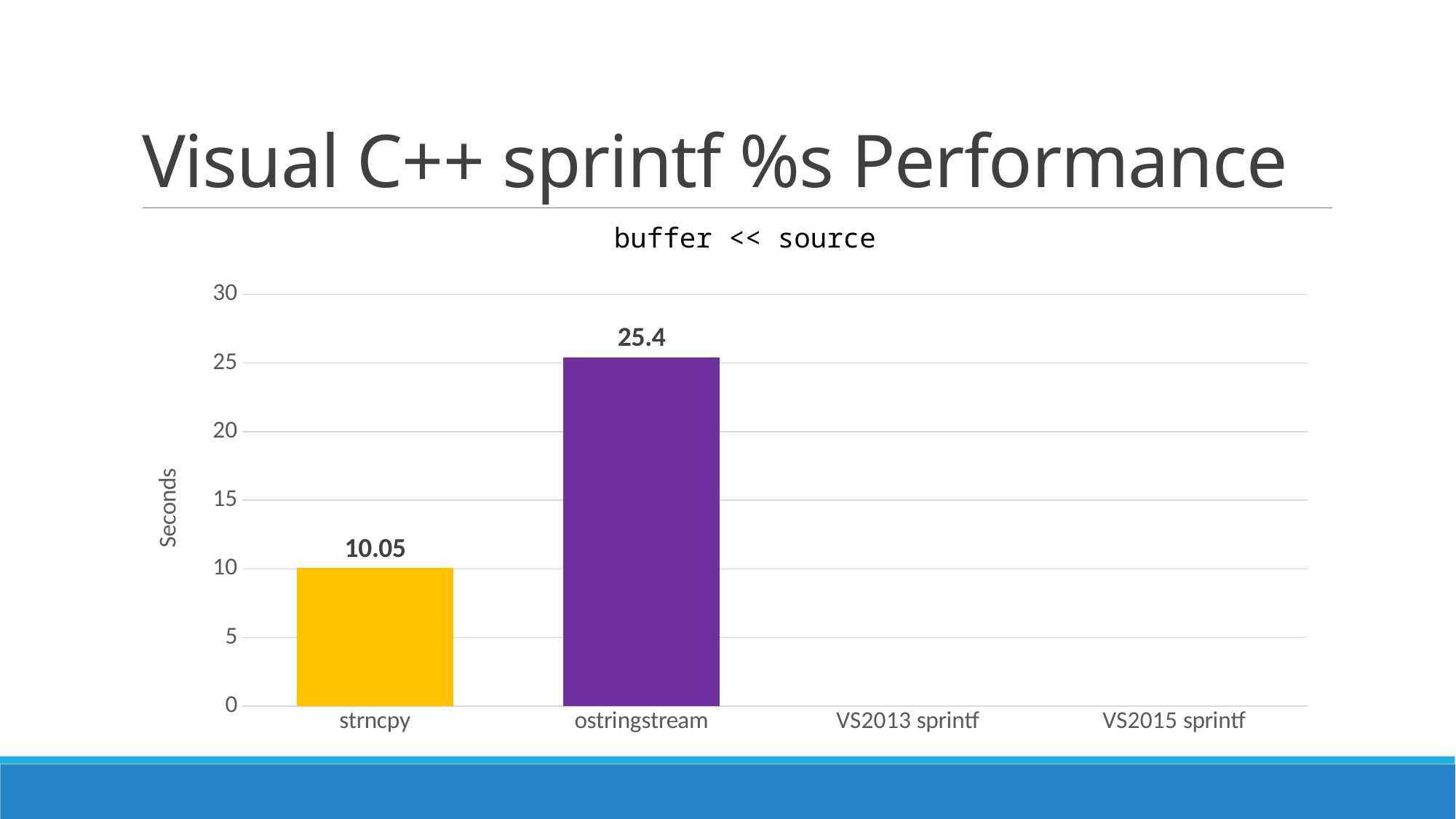
Is the value for ostringstream greater or less than 20? greater What is the value for ostringstream? 25.4 How many categories are labelled on the x axis? 4 Which is larger, the value for strncpy or the value for ostringstream? ostringstream How many categories have a visible bar plotted? 2 What is the difference between the ostringstream value and the strncpy value? 15.35 Is the value for strncpy greater or less than 15? less Which category has the highest bar? ostringstream What is the label on the y axis? Seconds What is the title of the chart? buffer << source What is the value for strncpy? 10.05 What kind of chart is shown on the slide? bar chart